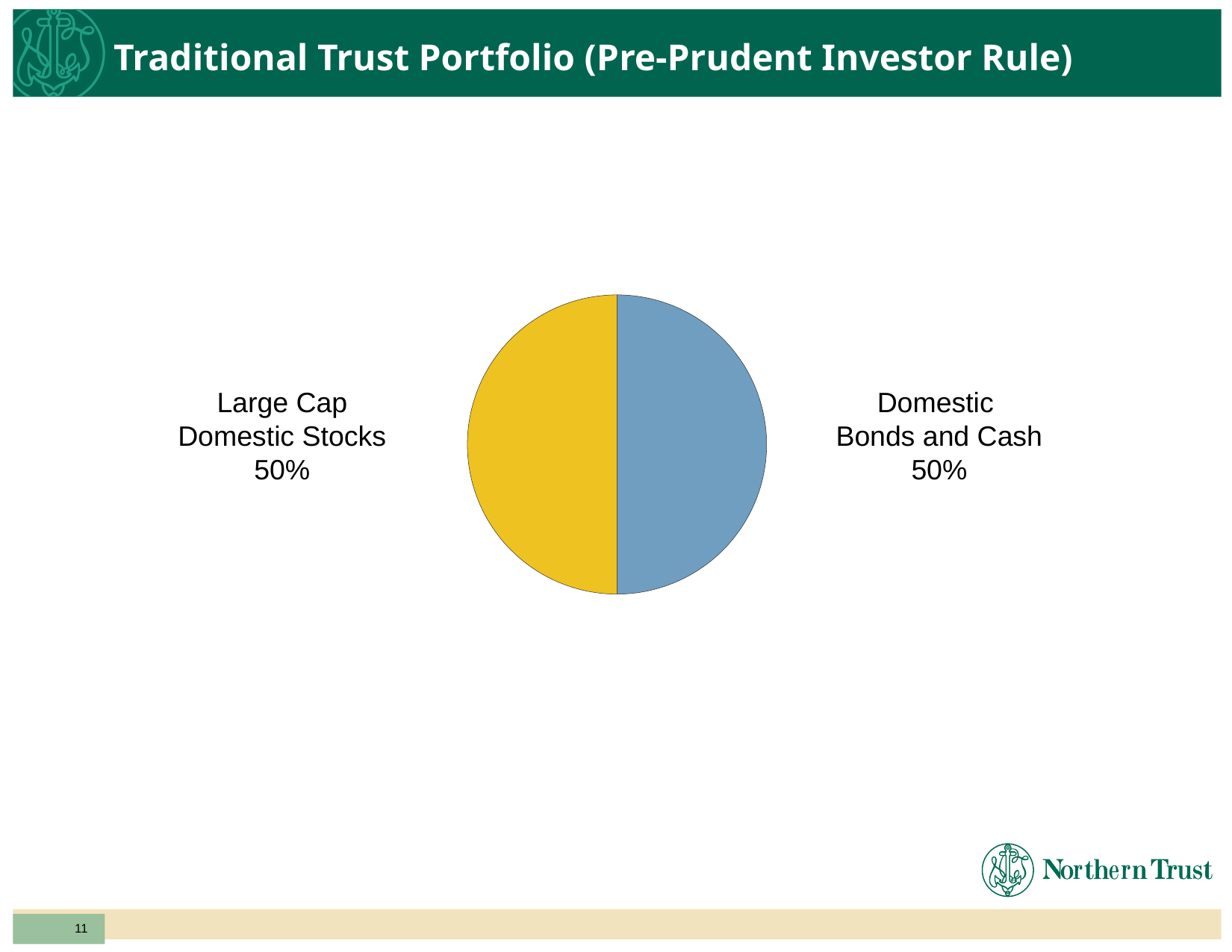
What share of the portfolio is Large Cap Domestic Stocks? 50% How many slices does the pie chart have? 2 What is the difference between the Large Cap Domestic Stocks share and the Domestic Bonds and Cash share? 0% What is the combined share of the two slices in the pie chart? 100% What kind of chart is shown on the slide? pie chart Which slice of the pie chart is coloured yellow? Large Cap Domestic Stocks What is the title of the slide containing the pie chart? Traditional Trust Portfolio (Pre-Prudent Investor Rule) Is the share for Large Cap Domestic Stocks larger than, smaller than, or equal to the share for Domestic Bonds and Cash? equal What share of the portfolio is Domestic Bonds and Cash? 50%